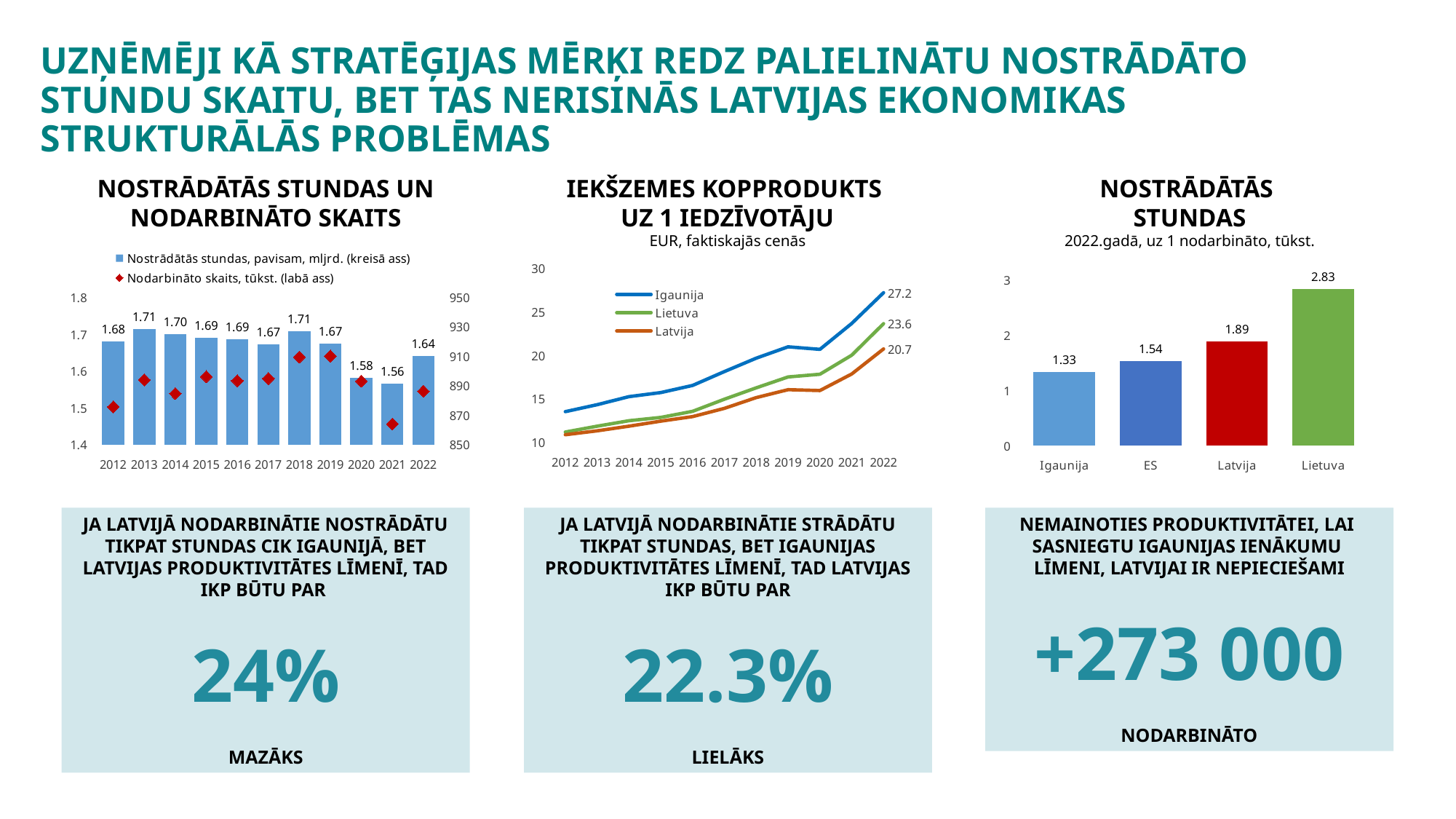
What kind of chart is 'NOSTRĀDĀTĀS STUNDAS' on the right? bar chart In the chart 'IEKŠZEMES KOPPRODUKTS UZ 1 IEDZĪVOTĀJU' in the middle, how many series does the legend list? 3 In the chart 'NOSTRĀDĀTĀS STUNDAS' on the right, what is the value for Latvija? 1.89 In the chart 'IEKŠZEMES KOPPRODUKTS UZ 1 IEDZĪVOTĀJU' in the middle, do the values for Latvija rise or fall from 2012 to 2022? rise In the chart 'NOSTRĀDĀTĀS STUNDAS' on the right, which category has the lowest value? Igaunija In the chart 'IEKŠZEMES KOPPRODUKTS UZ 1 IEDZĪVOTĀJU' in the middle, what is the value for Igaunija in 2022? 27.2 In the chart 'NOSTRĀDĀTĀS STUNDAS' on the right, what is the difference between the values for Lietuva and Latvija? 0.94 In the chart 'NOSTRĀDĀTĀS STUNDAS' on the right, which category has the highest value? Lietuva In the chart 'NOSTRĀDĀTĀS STUNDAS UN NODARBINĀTO SKAITS' on the left, what is the value of the bar for 2021? 1.56 In the chart 'NOSTRĀDĀTĀS STUNDAS' on the right, how many categories are shown? 4 In the chart 'NOSTRĀDĀTĀS STUNDAS UN NODARBINĀTO SKAITS' on the left, which year has the lowest bar? 2021 In the chart 'IEKŠZEMES KOPPRODUKTS UZ 1 IEDZĪVOTĀJU' in the middle, what is the difference between Igaunija and Latvija in 2022? 6.5